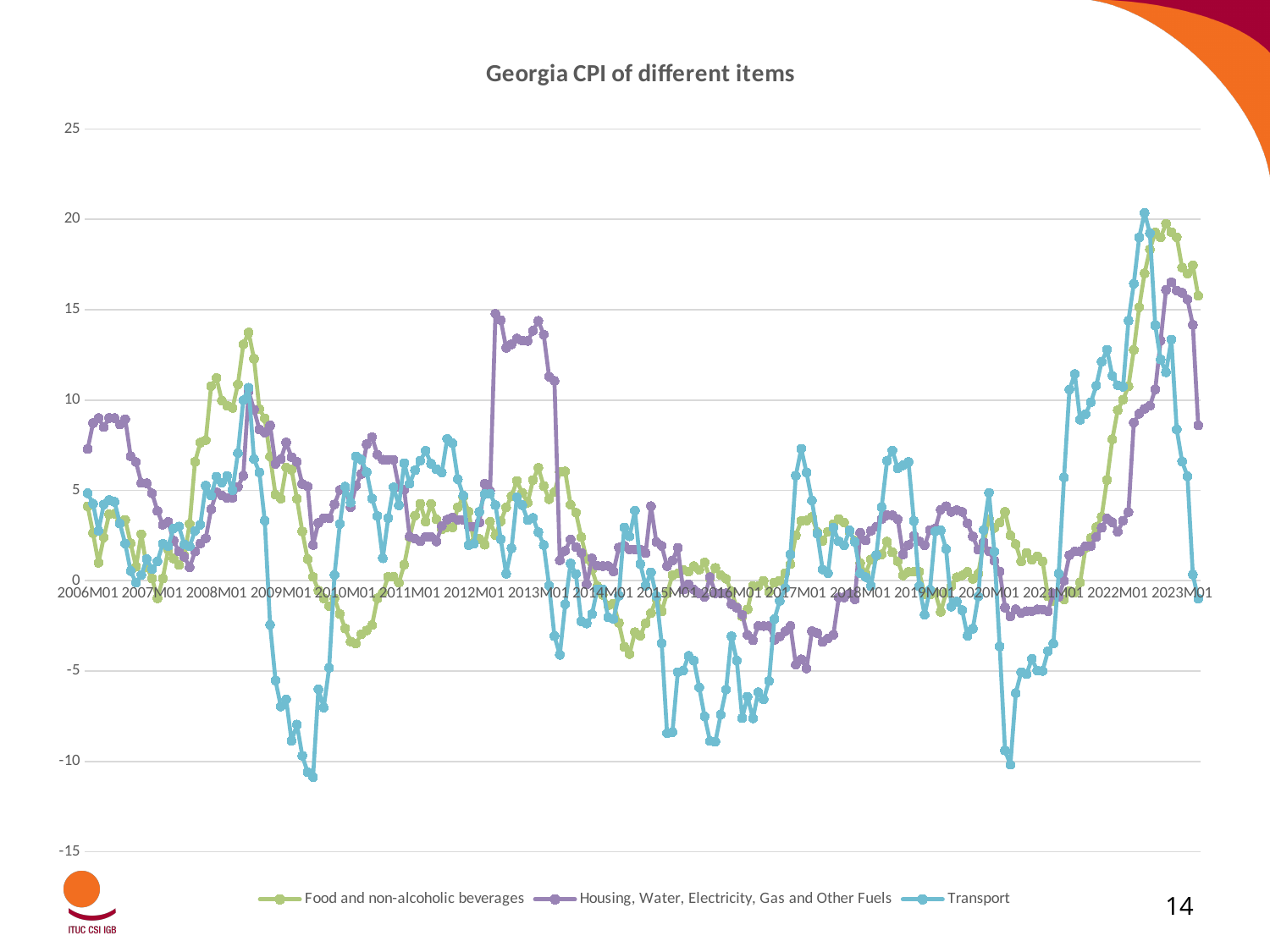
What is the title of the chart? Georgia CPI of different items What is the first x-axis label shown on the chart? 2006M01 Is the lowest value of the Transport series (around 2009) greater or less than -10? less Around 2012M01 to 2013M01, which series has the highest values: Food and non-alcoholic beverages, Housing, Water, Electricity, Gas and Other Fuels, or Transport? Housing, Water, Electricity, Gas and Other Fuels Which series reaches the lowest value anywhere on the chart? Transport How many series does the legend list? 3 Is the peak of the Housing, Water, Electricity, Gas and Other Fuels series around 2012 greater or less than 10? greater Is the peak of the Food and non-alcoholic beverages series around 2022 greater or less than 15? greater What kind of chart is shown on the slide? Line chart Around 2009M01, which series has the lowest values? Transport Which series is shown in purple in the legend? Housing, Water, Electricity, Gas and Other Fuels